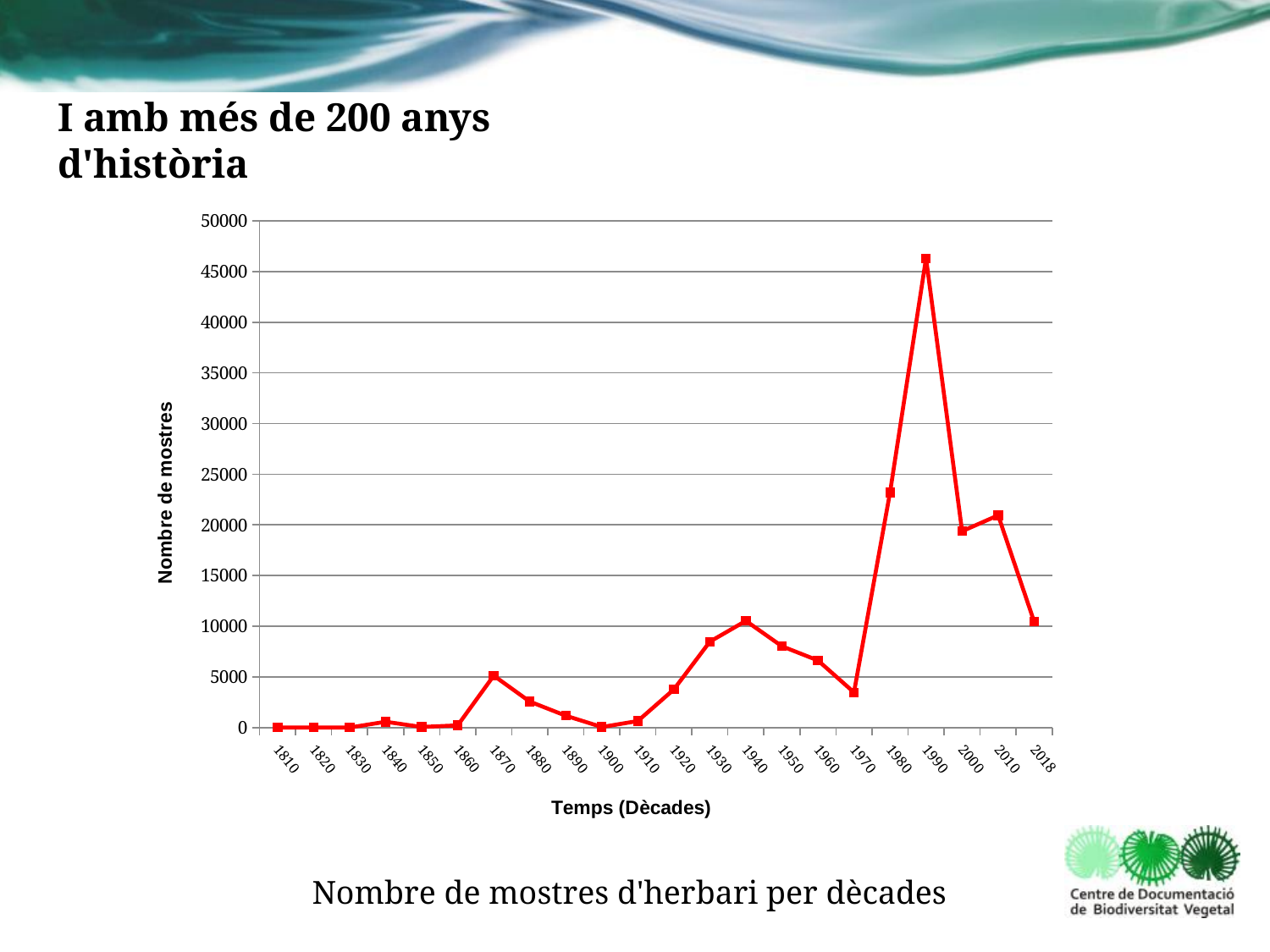
Is the value for 1970 greater or less than 5000? less Which decade has the highest number of samples (Nombre de mostres)? 1990 Is the value for 1960 greater or less than 5000? greater Do the values rise or fall from 1990 to 2000? fall How many data points are plotted on the x axis? 22 Is the value for 1990 greater or less than 40000? greater What is the title of the x axis? Temps (Dècades) What kind of chart is shown on the slide? line chart Which has a larger value, 1870 or 1880? 1870 Which has a larger value, 1980 or 1940? 1980